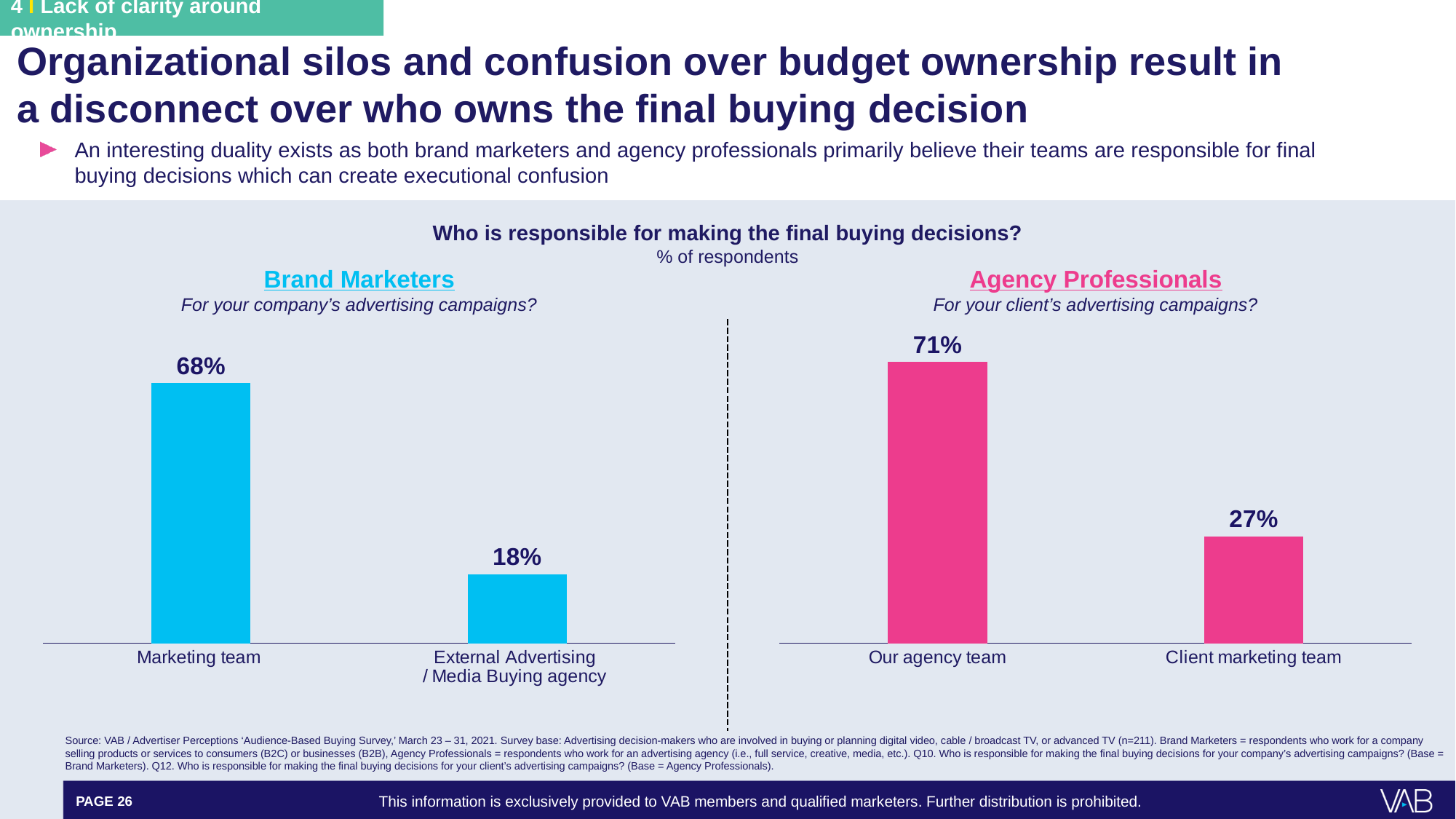
In the Agency Professionals chart, what is the difference between Our agency team and Client marketing team? 44% Which is larger: the Marketing team value in the Brand Marketers chart or the Our agency team value in the Agency Professionals chart? Our agency team In the Agency Professionals chart, which category has the lowest value? Client marketing team In the Brand Marketers chart, what is the difference between the Marketing team and External Advertising / Media Buying agency values? 50% In the Agency Professionals chart, what percentage of respondents said Our agency team is responsible? 71% How many categories are shown in the Brand Marketers chart? 2 In the Brand Marketers chart, which category has the highest value? Marketing team In the Agency Professionals chart, what is the value for Client marketing team? 27% What colour are the bars in the Agency Professionals chart? Pink What type of chart is the Agency Professionals chart? Bar chart In the Brand Marketers chart, what percentage of respondents said the Marketing team is responsible for final buying decisions? 68% In the Brand Marketers chart, what is the value for External Advertising / Media Buying agency? 18%